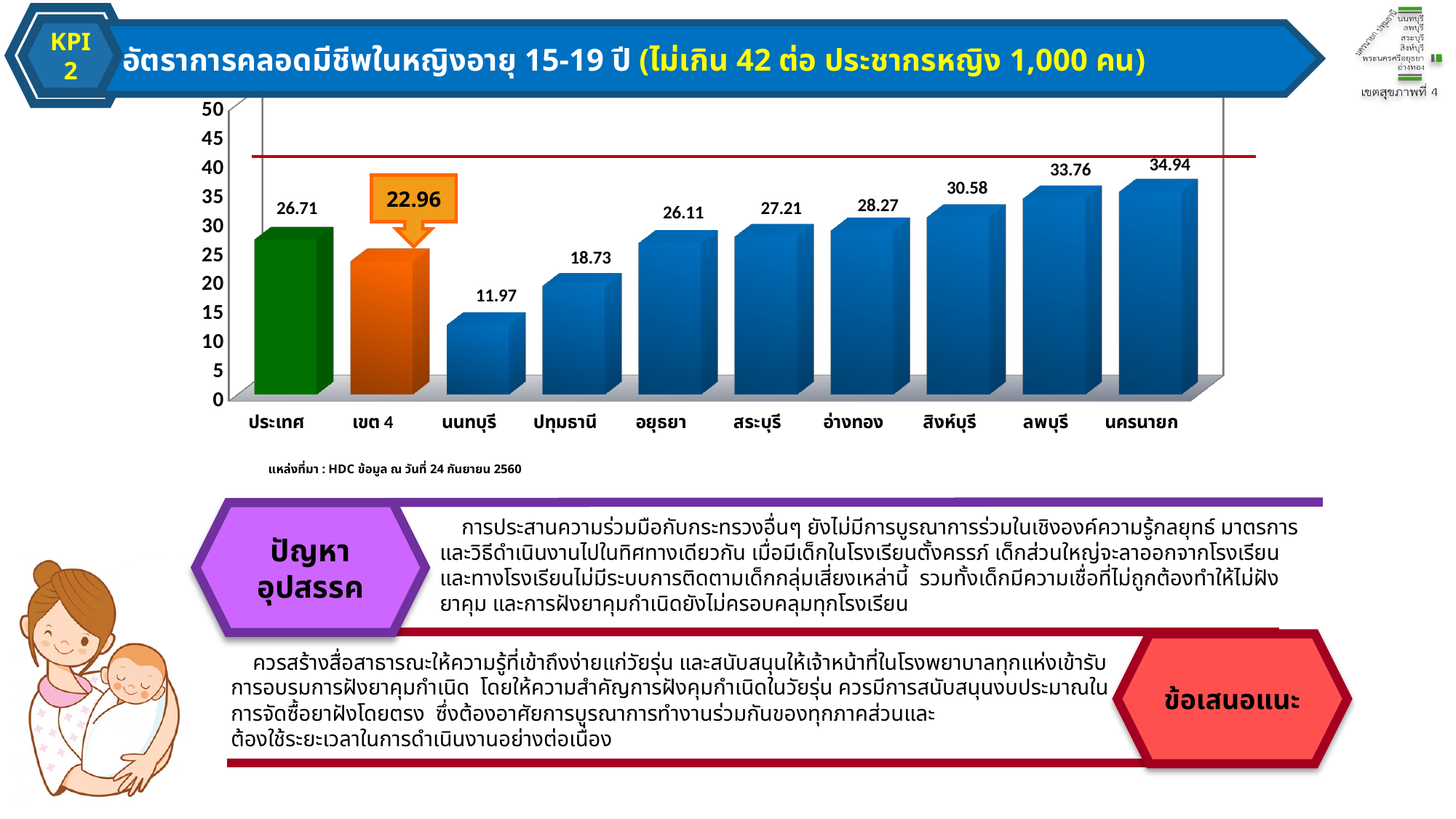
Which category has the lowest value? นนทบุรี Which is larger, the value for สระบุรี or the value for ปทุมธานี? สระบุรี Is the value for สิงห์บุรี greater or less than 40? less Which category has the highest value? นครนายก How many categories are shown on the x axis? 10 What is the difference between the values for ประเทศ and เขต 4? 3.75 What is the value for ลพบุรี? 33.76 What is the value for เขต 4? 22.96 What kind of chart is shown on the slide? bar chart What is the value for ประเทศ? 26.71 What is the value for นนทบุรี? 11.97 What is the difference between the values for นครนายก and นนทบุรี? 22.97